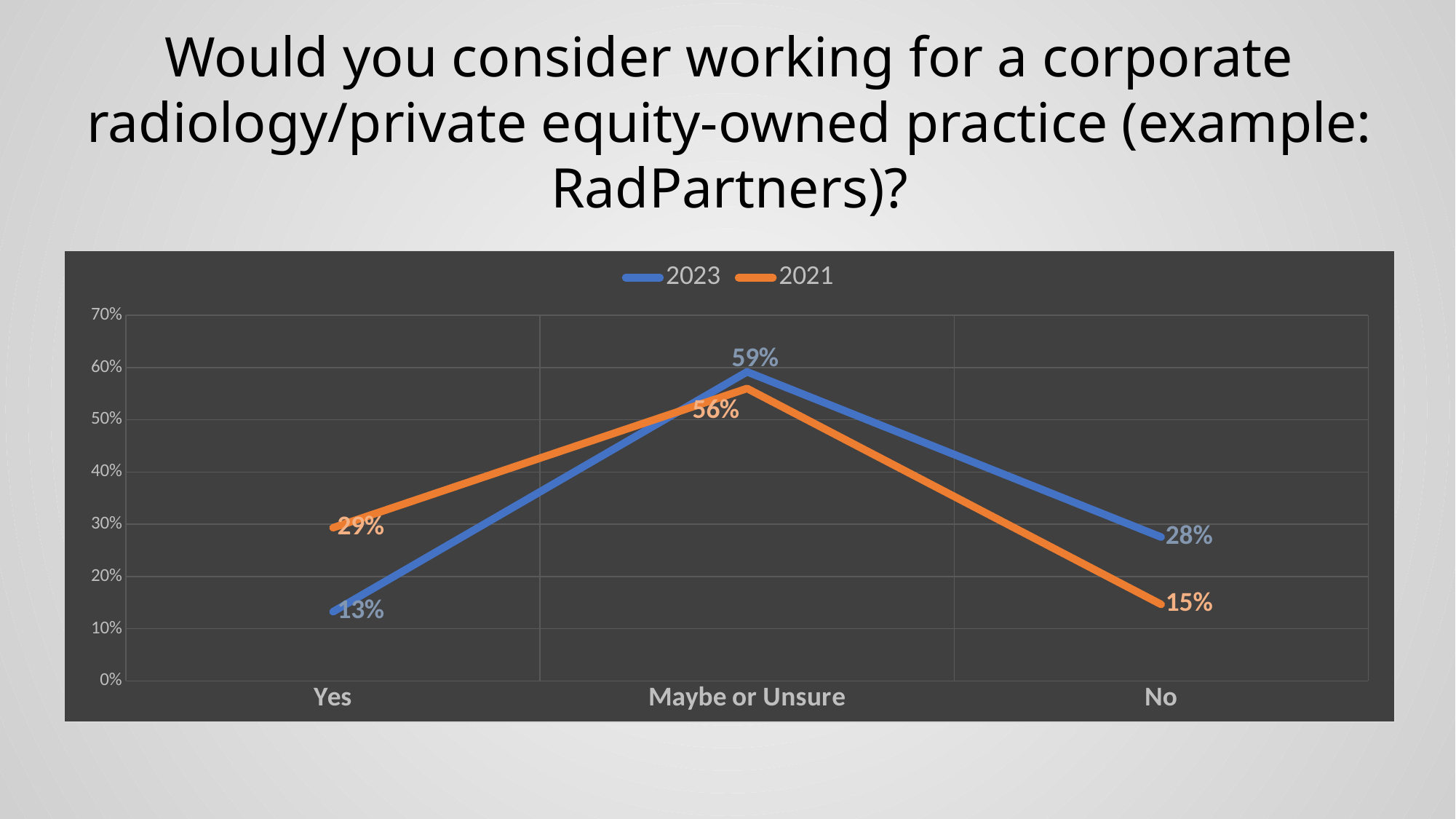
Which colour represents the 2021 series? Orange What is the 2023 value for Yes? 13% How many series does the legend list? 2 Which is larger for Yes, the 2023 value or the 2021 value? 2021 What kind of chart is shown on the slide? Line chart What is the difference between the 2023 and 2021 values for No? 13% What is the 2023 value for Maybe or Unsure? 59% Which category has the lowest value for the 2021 series? No What is the 2021 value for Yes? 29% What is the 2021 value for No? 15% How many categories are shown on the x axis? 3 Which category has the highest value for the 2023 series? Maybe or Unsure